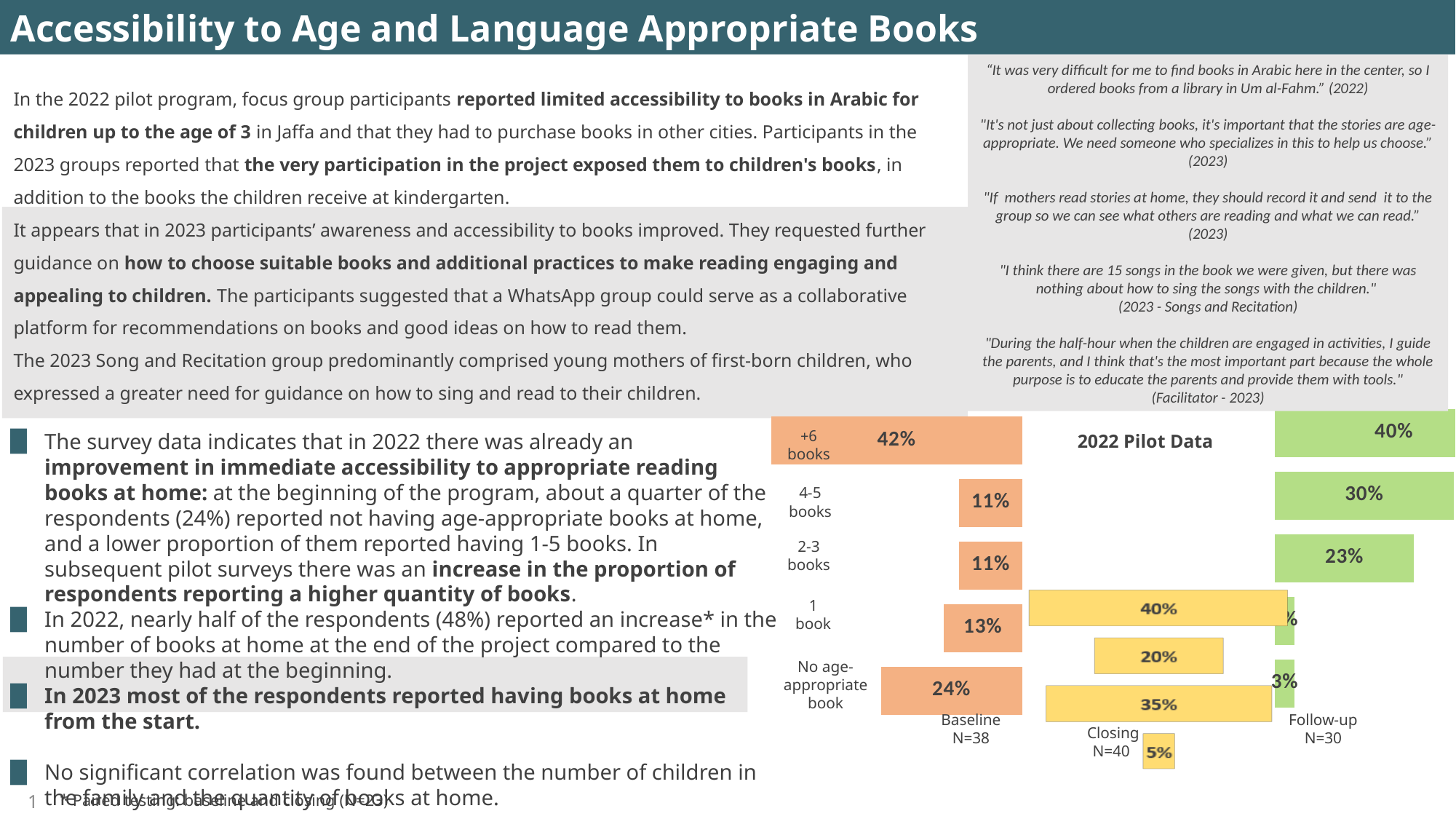
In the 2022 Pilot Data chart, what is the Follow-up value for '4-5 books'? 30% What kind of chart is the 2022 Pilot Data chart? Bar chart In the 2022 Pilot Data chart, what is the Baseline value for 'No age-appropriate book'? 24% How many book-quantity categories are shown in the 2022 Pilot Data chart? 5 In the 2022 Pilot Data chart, what is the Follow-up value for '+6 books'? 40% In the 2022 Pilot Data chart, what is the Follow-up value for '2-3 books'? 23% In the 2022 Pilot Data chart, what is the Baseline value for '1 book'? 13% In the 2022 Pilot Data chart, what is the Baseline value for '+6 books'? 42% In the 2022 Pilot Data chart, what is the difference between the Baseline values for '+6 books' and 'No age-appropriate book'? 18 percentage points In the 2022 Pilot Data chart, for '4-5 books', which is larger: the Baseline value or the Follow-up value? Follow-up How many survey waves (series) are shown in the 2022 Pilot Data chart? 3 In the 2022 Pilot Data chart, which category has the highest Baseline value? +6 books